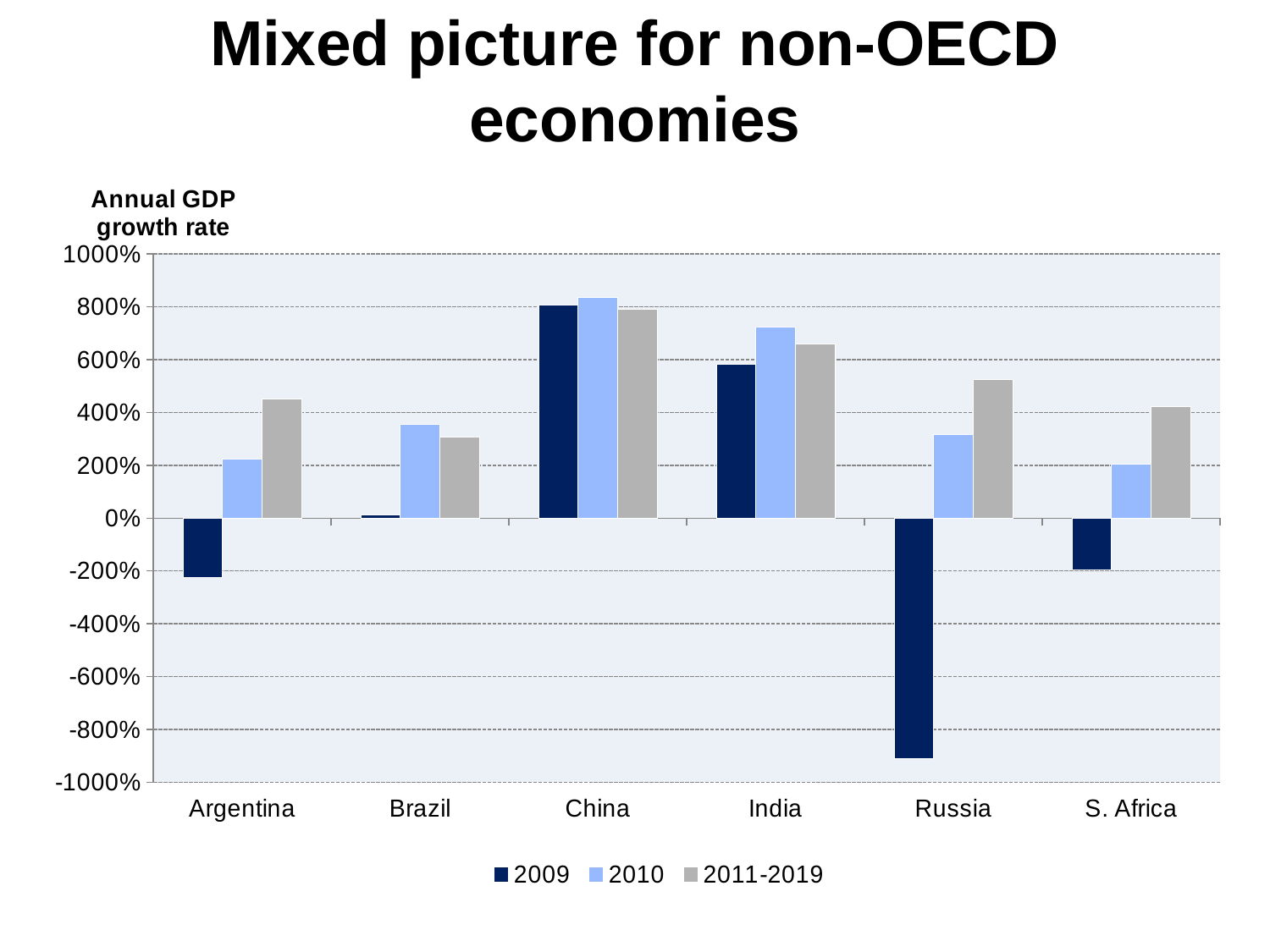
How many countries are shown on the x axis of the chart? 6 Is the 2009 value for Russia greater or less than -800%? less Which is larger, the 2010 value for India or the 2010 value for Brazil? India Which is larger, the 2011-2019 value for Russia or the 2011-2019 value for Argentina? Russia What kind of chart is shown on the slide? bar chart What label is shown on the vertical axis of the chart? Annual GDP growth rate How many series does the chart's legend list? 3 Is the 2011-2019 value for Russia greater or less than 400%? greater Which country has the lowest value for 2009? Russia Which country has the highest value for 2010? China Is the 2010 value for Brazil greater or less than 200%? greater Which country has the highest value for 2009? China